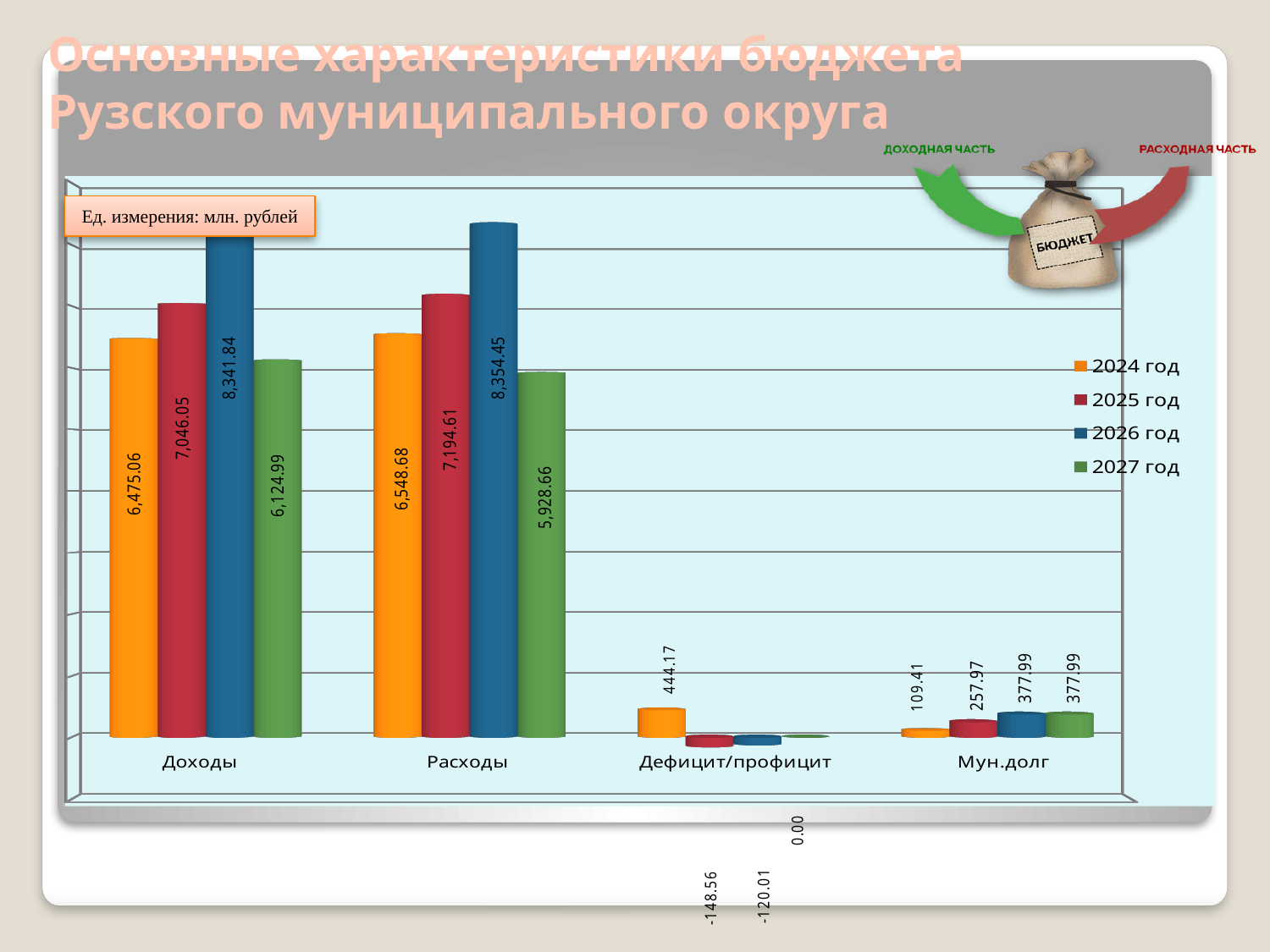
What is the value for Мун.долг in 2024 год? 109.41 How many series does the legend list? 4 Which is larger in 2024 год: Доходы or Расходы? Расходы How many categories are shown on the x axis? 4 Which year has the lowest value for Расходы? 2027 год What kind of chart is shown on the slide? Bar chart What is the value for Доходы in 2026 год? 8,341.84 What is the difference between Расходы and Доходы in 2025 год? 148.56 What is the value for Расходы in 2027 год? 5,928.66 Which year has the highest value for Доходы? 2026 год What unit of measurement is stated for the chart values? млн. рублей What is the value for Дефицит/профицит in 2024 год? 444.17